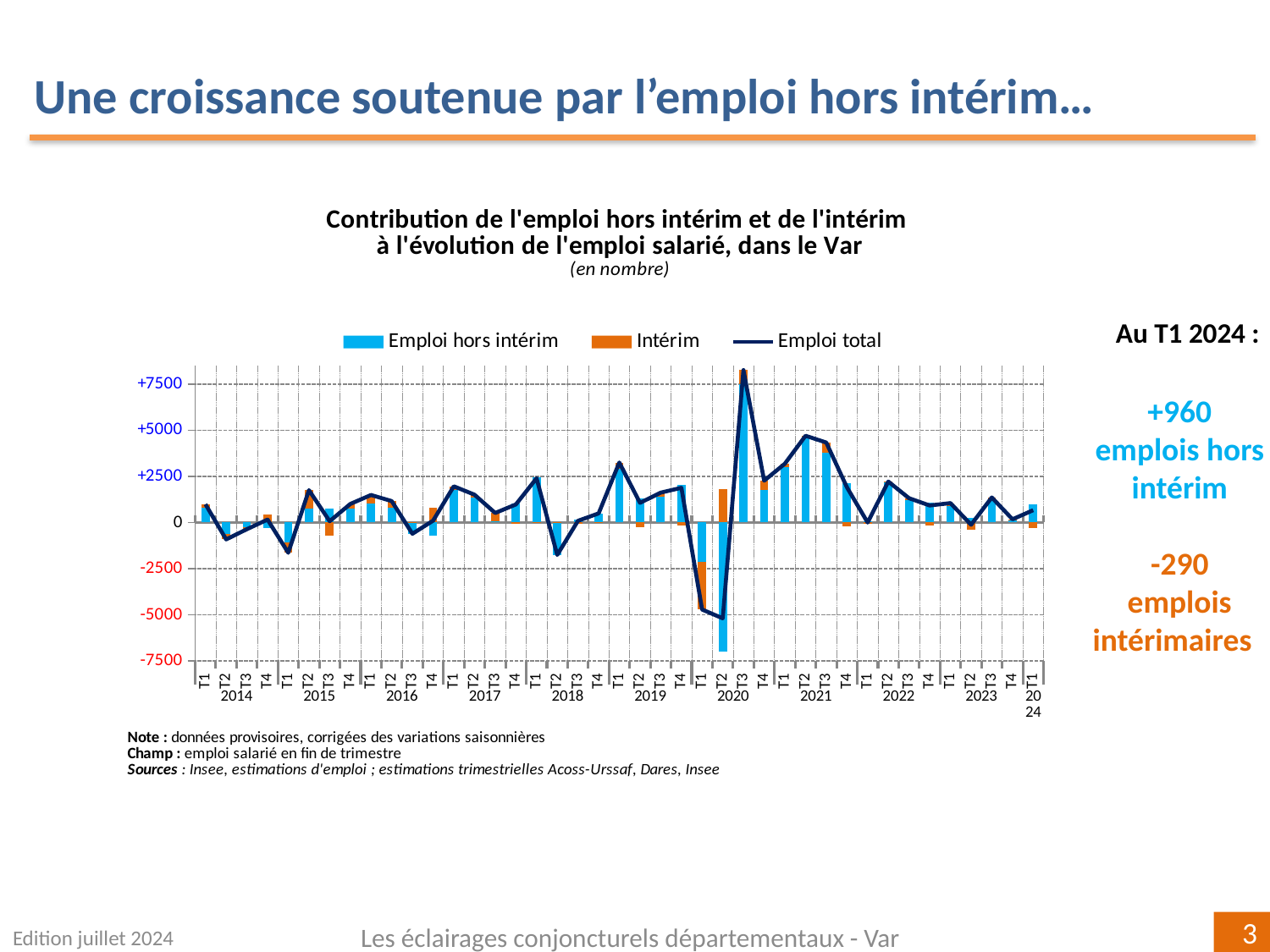
What is the value of Intérim at T1 2024? -290 What is the value of Emploi hors intérim at T1 2024? +960 What are the three series listed in the legend? Emploi hors intérim, Intérim, Emploi total In which quarter does Emploi hors intérim reach its lowest value? T2 2020 Is the value of Emploi hors intérim at T2 2020 greater or less than -5000? less At T1 2024, which is larger: Emploi hors intérim or Intérim? Emploi hors intérim How many series does the legend list? 3 How many years are labelled on the x axis? 11 Which colour represents the Intérim series? orange Is the value of Emploi total at T3 2020 greater or less than 7500? greater In which quarter does Emploi total reach its highest value? T3 2020 What kind of chart is shown on the slide? bar and line chart